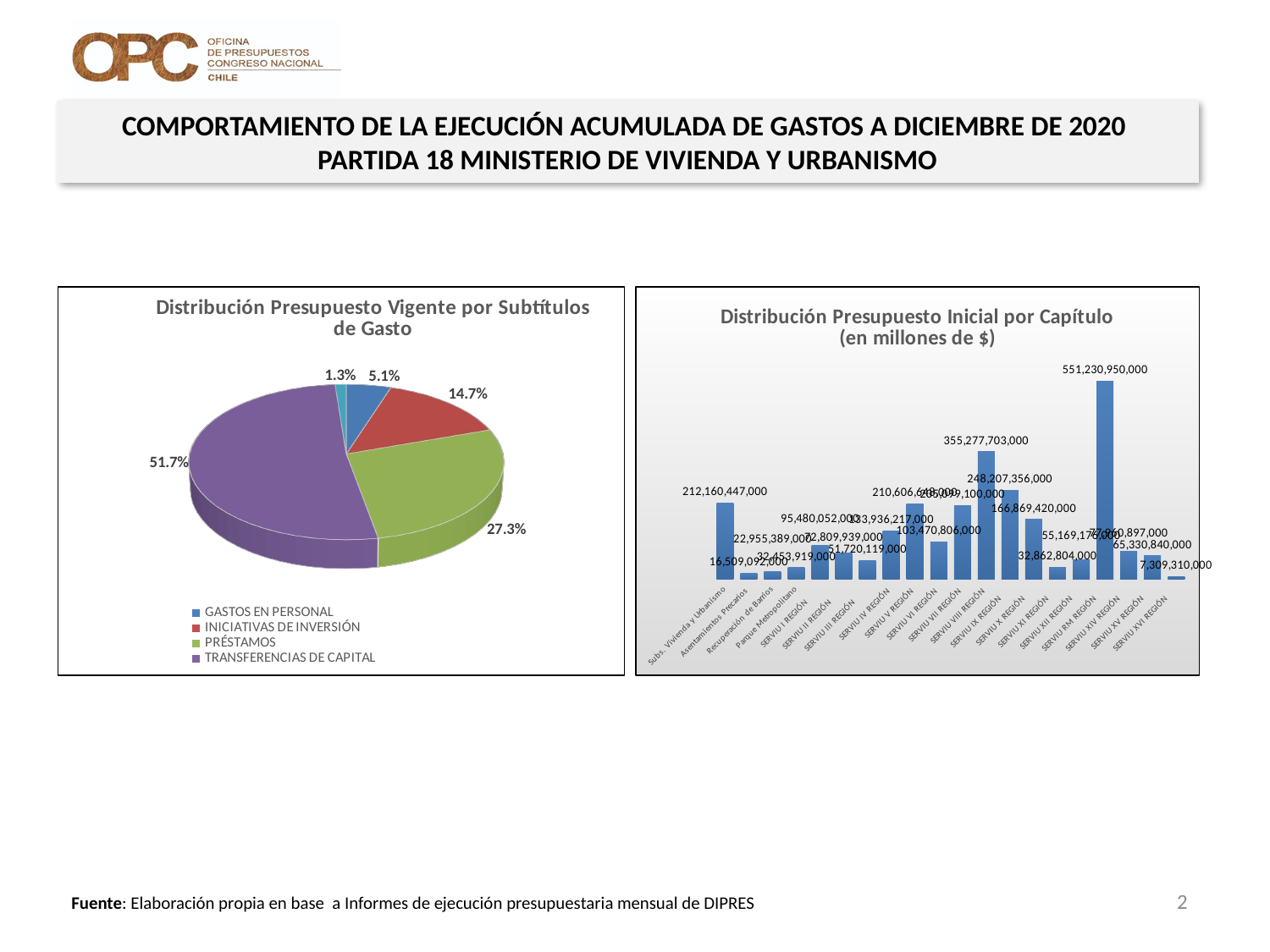
In the chart 'Distribución Presupuesto Inicial por Capítulo', which capítulo has the highest value? SERVIU RM REGIÓN In the chart 'Distribución Presupuesto Vigente por Subtítulos de Gasto', which legend category has the largest slice? TRANSFERENCIAS DE CAPITAL What kind of chart is 'Distribución Presupuesto Vigente por Subtítulos de Gasto'? Pie chart In the chart 'Distribución Presupuesto Vigente por Subtítulos de Gasto', which is larger: INICIATIVAS DE INVERSIÓN or GASTOS EN PERSONAL? INICIATIVAS DE INVERSIÓN What kind of chart is 'Distribución Presupuesto Inicial por Capítulo'? Bar chart In the chart 'Distribución Presupuesto Inicial por Capítulo', what is the value for Subs. Vivienda y Urbanismo? 212,160,447,000 In the chart 'Distribución Presupuesto Inicial por Capítulo', which capítulo has the lowest value? SERVIU XVI REGIÓN In the chart 'Distribución Presupuesto Inicial por Capítulo', what is the value for SERVIU VIII REGIÓN? 355,277,703,000 How many entries does the legend of 'Distribución Presupuesto Vigente por Subtítulos de Gasto' list? 4 In the chart 'Distribución Presupuesto Vigente por Subtítulos de Gasto', what share does TRANSFERENCIAS DE CAPITAL have? 51.7% In the chart 'Distribución Presupuesto Vigente por Subtítulos de Gasto', what share does PRÉSTAMOS have? 27.3% In the chart 'Distribución Presupuesto Inicial por Capítulo', what is the difference between SERVIU RM REGIÓN and SERVIU VIII REGIÓN? 195,953,247,000